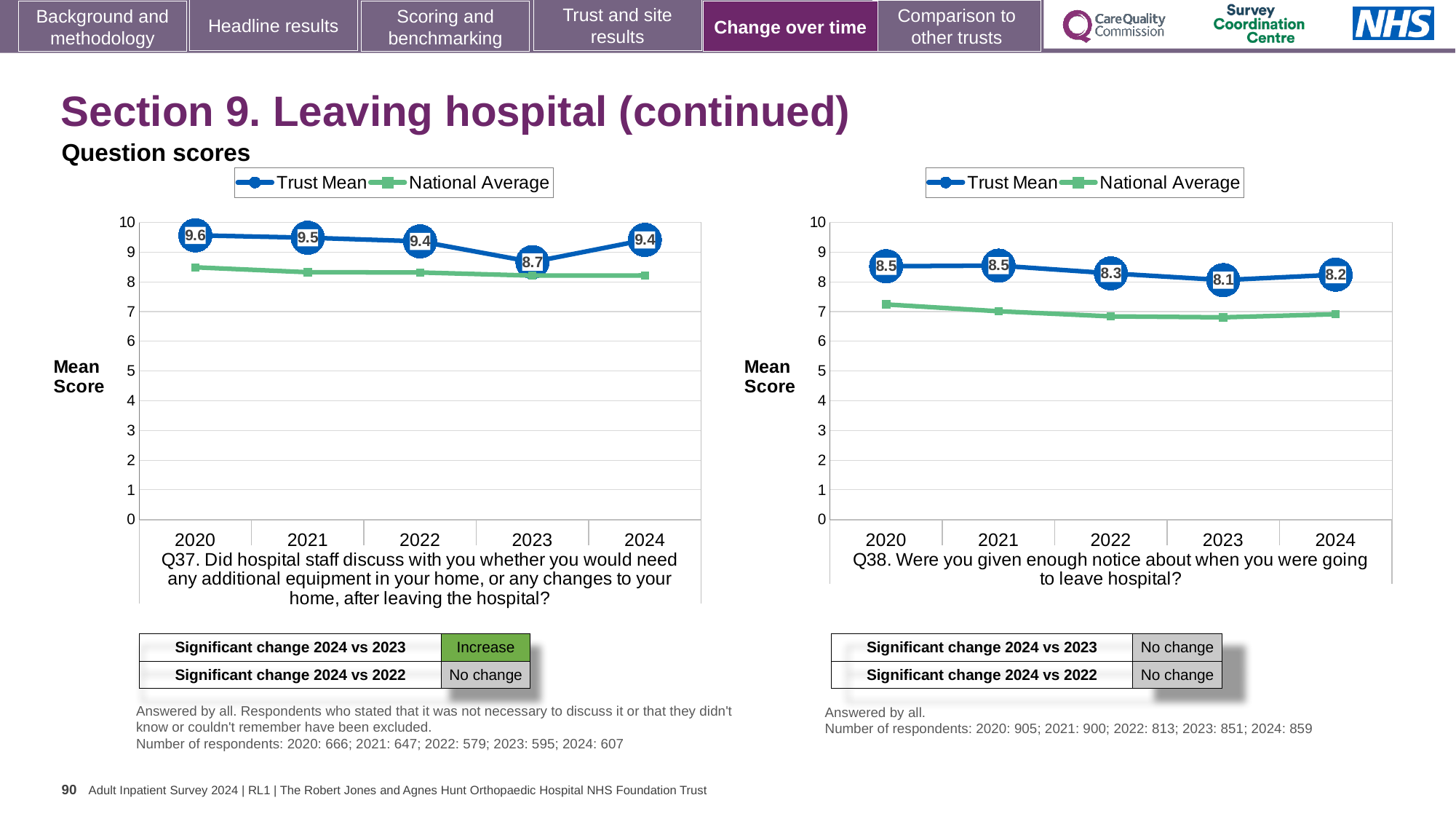
In the Q37 chart on the left, is the National Average for 2024 greater or less than 9? less In the Q37 chart on the left, what is the difference between the Trust Mean in 2024 and in 2023? 0.7 In the Q37 chart on the left, what is the Trust Mean for 2023? 8.7 In the Q38 chart on the right, what is the Trust Mean for 2024? 8.2 In the Q37 chart on the left, which year has the highest Trust Mean? 2020 In the Q38 chart on the right, what is the difference between the Trust Mean in 2020 and in 2023? 0.4 In the Q38 chart on the right, which year has the lowest Trust Mean? 2023 In the Q38 chart on the right, is the Trust Mean for 2022 higher or lower than the Trust Mean for 2023? higher In the Q38 chart on the right, is the National Average for 2020 greater or less than 8? less How many series does the legend of the Q38 chart on the right list? 2 In the Q37 chart on the left, what is the Trust Mean for 2020? 9.6 How many years are plotted on the x axis of the Q37 chart on the left? 5